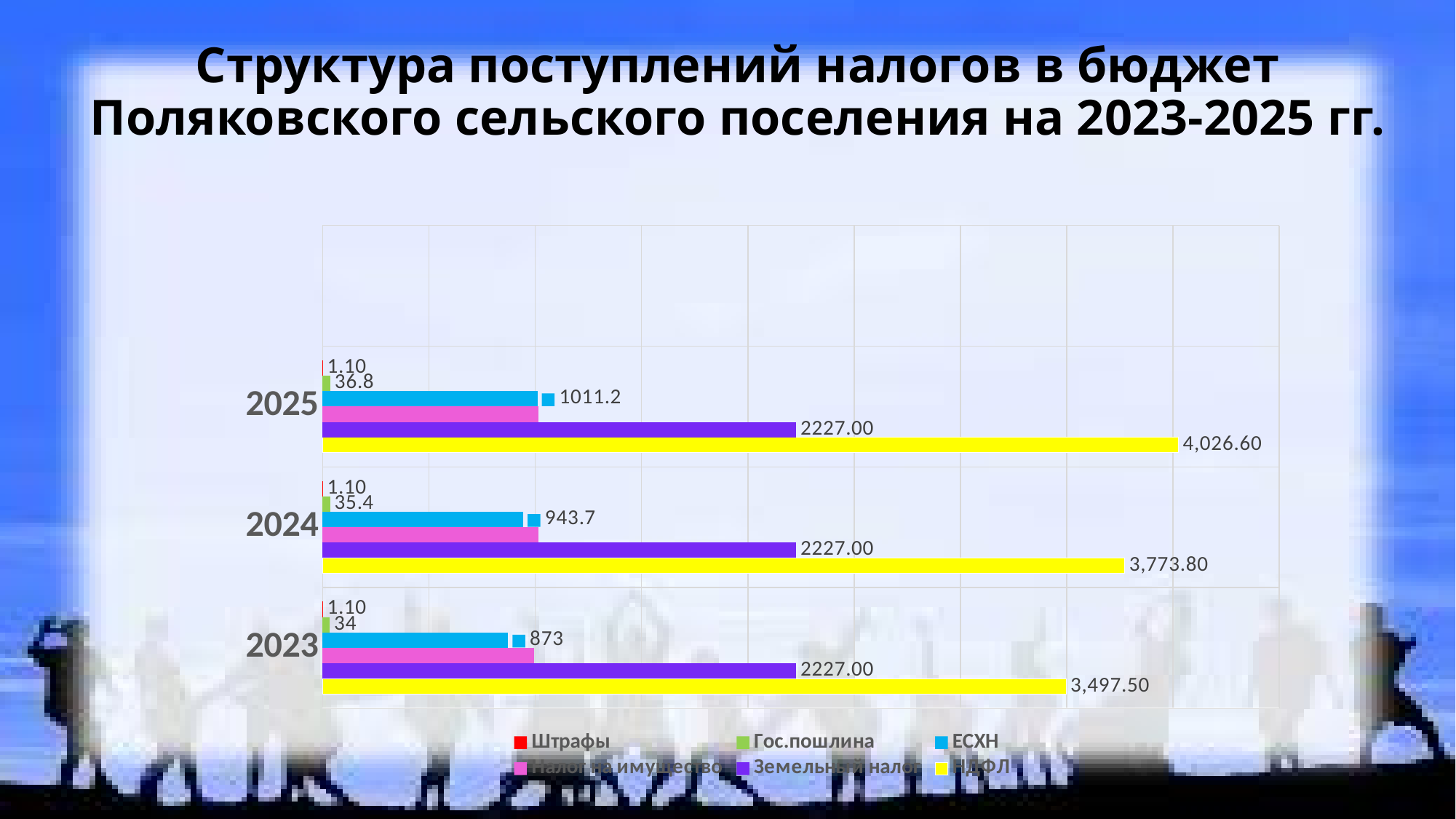
What is the value of Штрафы for 2023? 1.10 What is the value of Гос.пошлина for 2024? 35.4 How many series does the legend list? 6 How many years are shown on the chart? 3 What is the value of НДФЛ for 2025? 4,026.60 Which is larger: ЕСХН in 2024 or ЕСХН in 2025? ЕСХН in 2025 What kind of chart is shown on the slide? Bar chart What is the value of ЕСХН for 2023? 873 In which year is НДФЛ highest? 2025 In which year is ЕСХН lowest? 2023 What is the difference between НДФЛ in 2025 and НДФЛ in 2023? 529.10 What is the value of Земельный налог for 2024? 2227.00